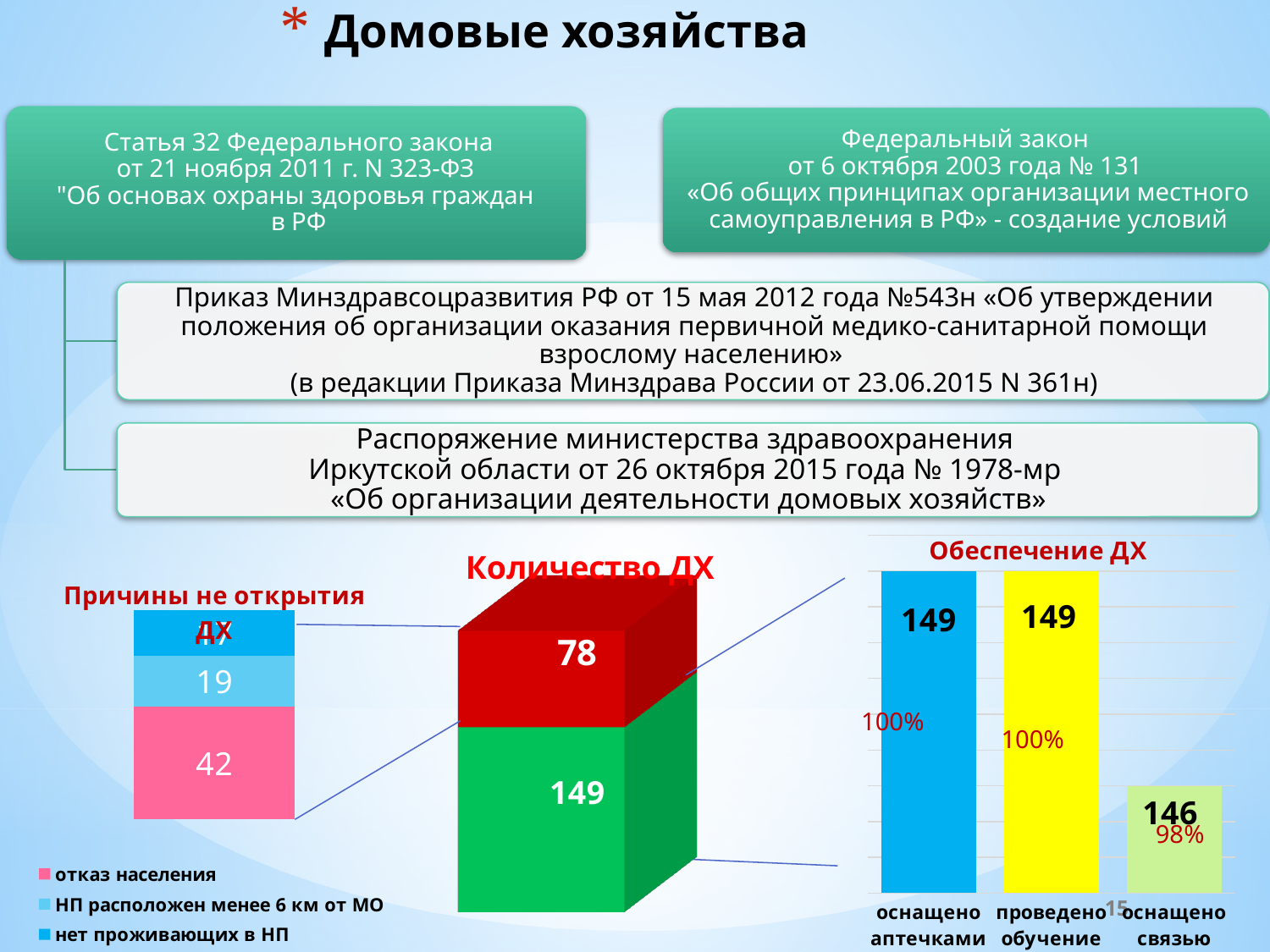
In the chart titled "Обеспечение ДХ", which category has the lowest value? оснащено связью In the chart titled "Обеспечение ДХ", what is the difference between the value for "проведено обучение" and the value for "оснащено связью"? 3 In the chart titled "Количество ДХ", what is the value of the green segment? 149 In the chart titled "Причины не открытия ДХ", how many entries does the legend list? 3 In the chart titled "Обеспечение ДХ", what percentage is shown for "оснащено связью"? 98% In the chart titled "Причины не открытия ДХ", what is the value for "НП расположен менее 6 км от МО"? 19 In the chart titled "Обеспечение ДХ", what is the value for "оснащено связью"? 146 In the chart titled "Причины не открытия ДХ", what is the value for "отказ населения"? 42 In the chart titled "Количество ДХ", what is the total of the stacked bar? 227 In the chart titled "Количество ДХ", what is the value of the red segment? 78 In the chart titled "Обеспечение ДХ", how many categories are shown? 3 In the chart titled "Обеспечение ДХ", what is the value for "оснащено аптечками"? 149